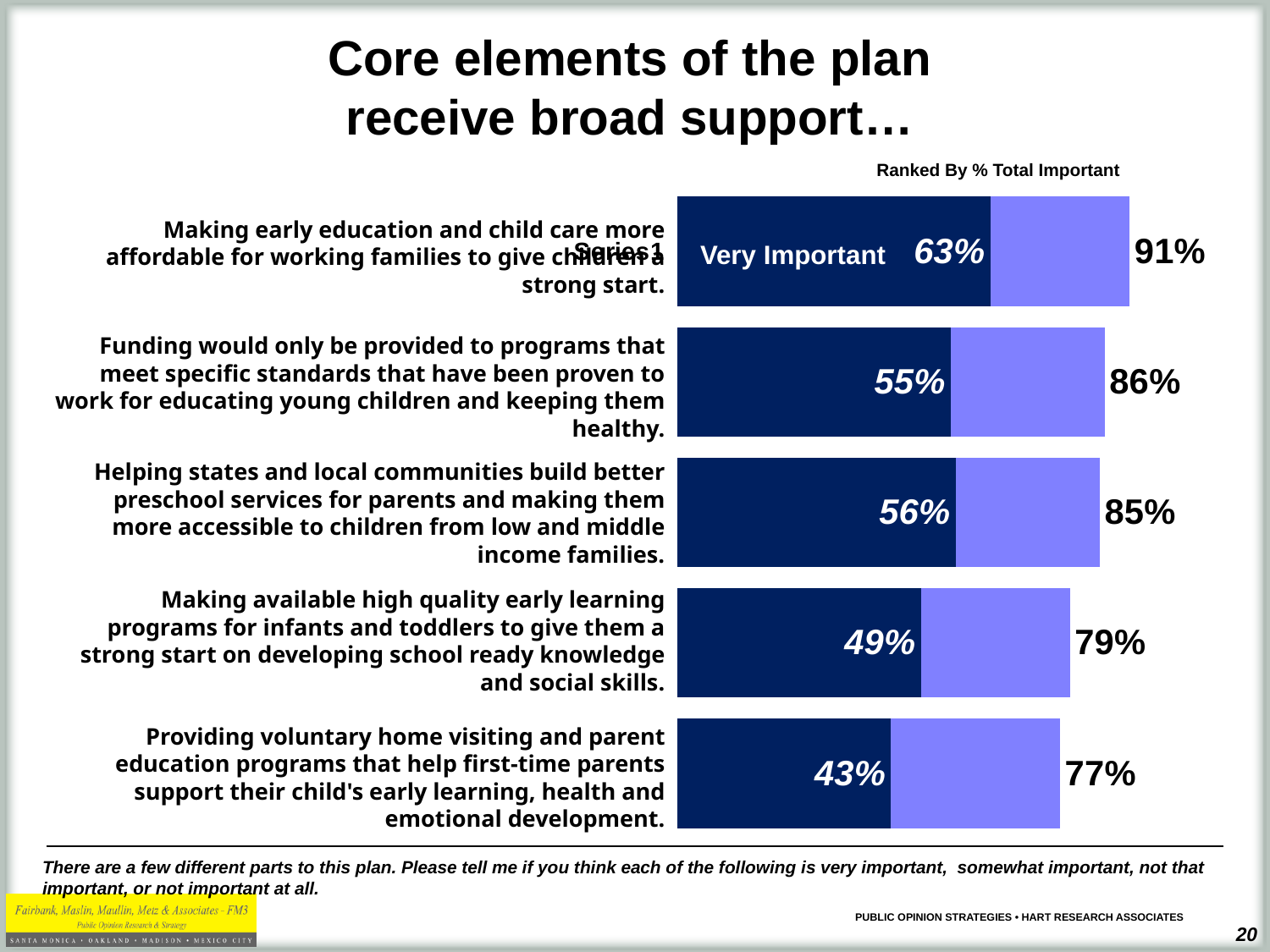
By what measure are the bars ranked, according to the label above the chart? % Total Important What is the difference between the total important and very important percentages for 'Making available high quality early learning programs for infants and toddlers'? 30% Which plan element has the highest total important percentage? Making early education and child care more affordable for working families to give children a strong start. What percentage rated 'Making early education and child care more affordable for working families' as very important? 63% What percentage rated 'Helping states and local communities build better preschool services' as very important? 56% How many plan elements are shown in the chart? 5 What kind of chart is shown on the slide? Stacked bar chart Which plan element has the lowest very important percentage? Providing voluntary home visiting and parent education programs that help first-time parents support their child's early learning, health and emotional development. What is the total important percentage for 'Providing voluntary home visiting and parent education programs'? 77% What does the dark blue segment of each bar represent? Very Important Which has a higher very important percentage: 'Funding would only be provided to programs that meet specific standards' or 'Helping states and local communities build better preschool services'? Helping states and local communities build better preschool services What is the total important percentage for 'Funding would only be provided to programs that meet specific standards'? 86%